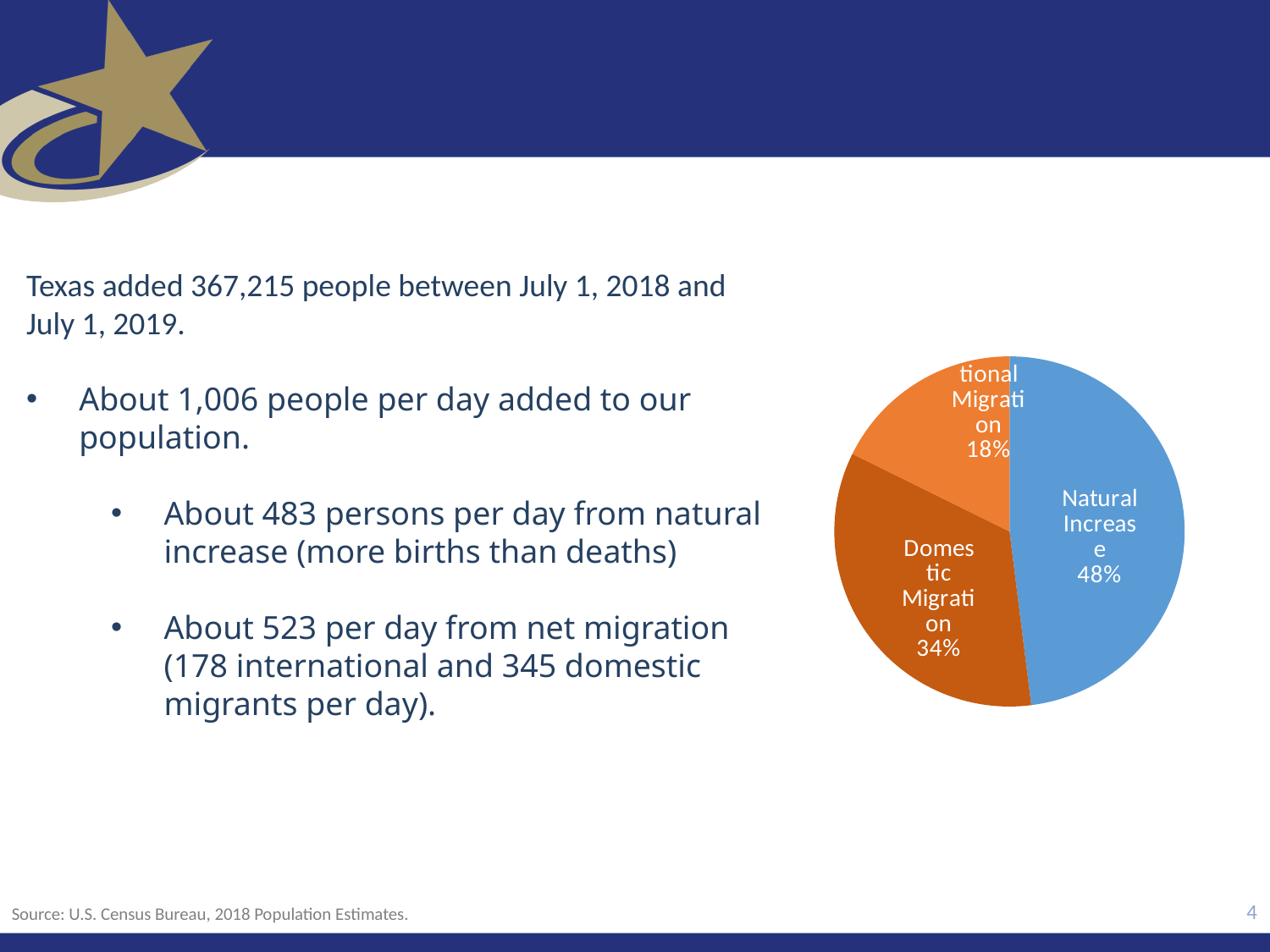
What share of the pie does International Migration account for? 18% What kind of chart is shown on the slide? Pie chart What is the difference in percentage points between the Natural Increase slice and the Domestic Migration slice? 14 percentage points Is the share for Domestic Migration greater or less than 50%? less What share of the pie does Natural Increase account for? 48% Which slice of the pie chart is the largest? Natural Increase Which is larger in the pie chart, Domestic Migration or Natural Increase? Natural Increase What colour is the Natural Increase slice in the pie chart? Blue Which slice of the pie chart is the smallest? International Migration What share of the pie does Domestic Migration account for? 34% What is the combined share of the Domestic Migration and International Migration slices? 52% How many slices does the pie chart have? 3